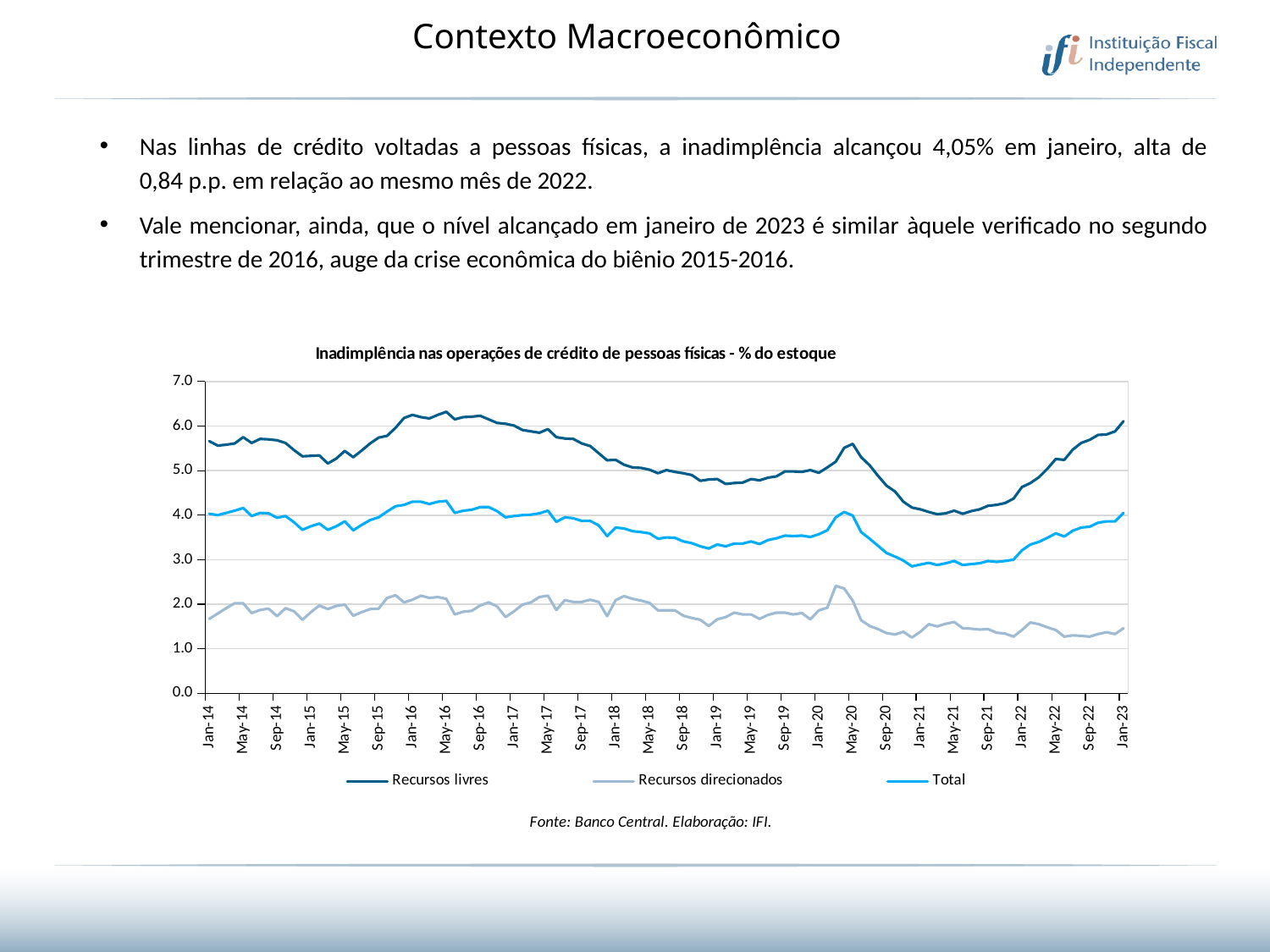
How many series does the legend of the chart list? 3 Does the Recursos livres series rise or fall between May-16 and Jan-19? Fall What is the title of the chart? Inadimplência nas operações de crédito de pessoas físicas - % do estoque Which is larger in Jan-18: Recursos livres or Recursos direcionados? Recursos livres Is the value of Total in Jan-21 greater or less than 4.0? less Is the value of Recursos direcionados in Jan-23 greater or less than 2.0? less Which series is plotted with the highest values throughout the chart? Recursos livres Is the value of Recursos livres in Jan-16 greater or less than 5.0? greater Which series is plotted with the lowest values throughout the chart? Recursos direcionados What kind of chart is shown on the slide? Line chart Does the Total series rise or fall between Jan-21 and Jan-23? Rise